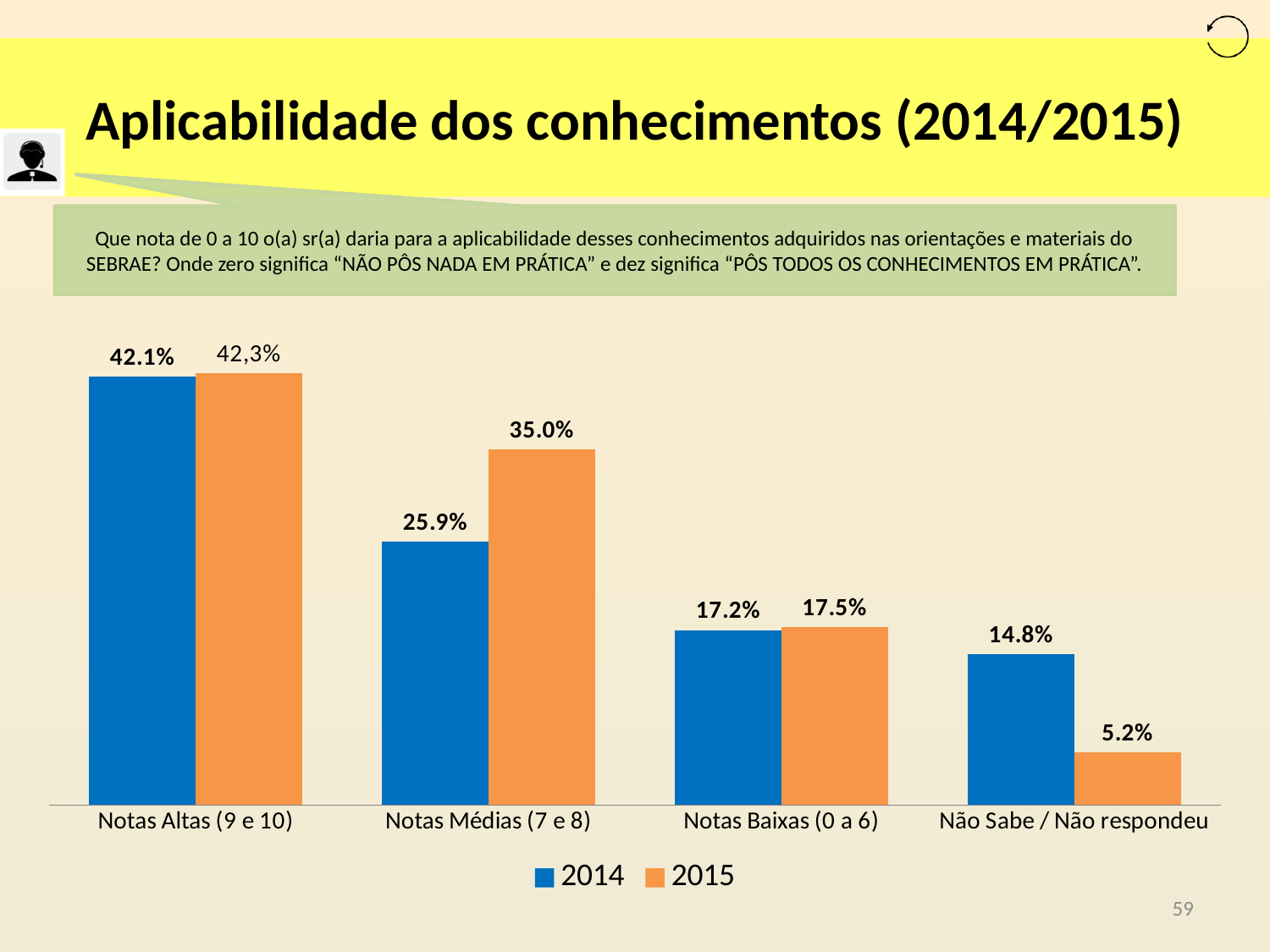
What is the 2015 value for Notas Altas (9 e 10)? 42,3% What is the 2014 value for Notas Baixas (0 a 6)? 17.2% How many categories are shown on the x axis? 4 What kind of chart is shown on the slide? Bar chart What is the 2015 value for Não Sabe / Não respondeu? 5.2% Which category has the lowest 2015 value? Não Sabe / Não respondeu How many series does the legend list? 2 Which colour represents the 2015 series in the legend? Orange For Não Sabe / Não respondeu, which year has the larger value, 2014 or 2015? 2014 Which category has the highest 2014 value? Notas Altas (9 e 10) What is the difference between the 2015 and 2014 values for Notas Médias (7 e 8)? 9.1 percentage points What is the 2014 value for Notas Médias (7 e 8)? 25.9%